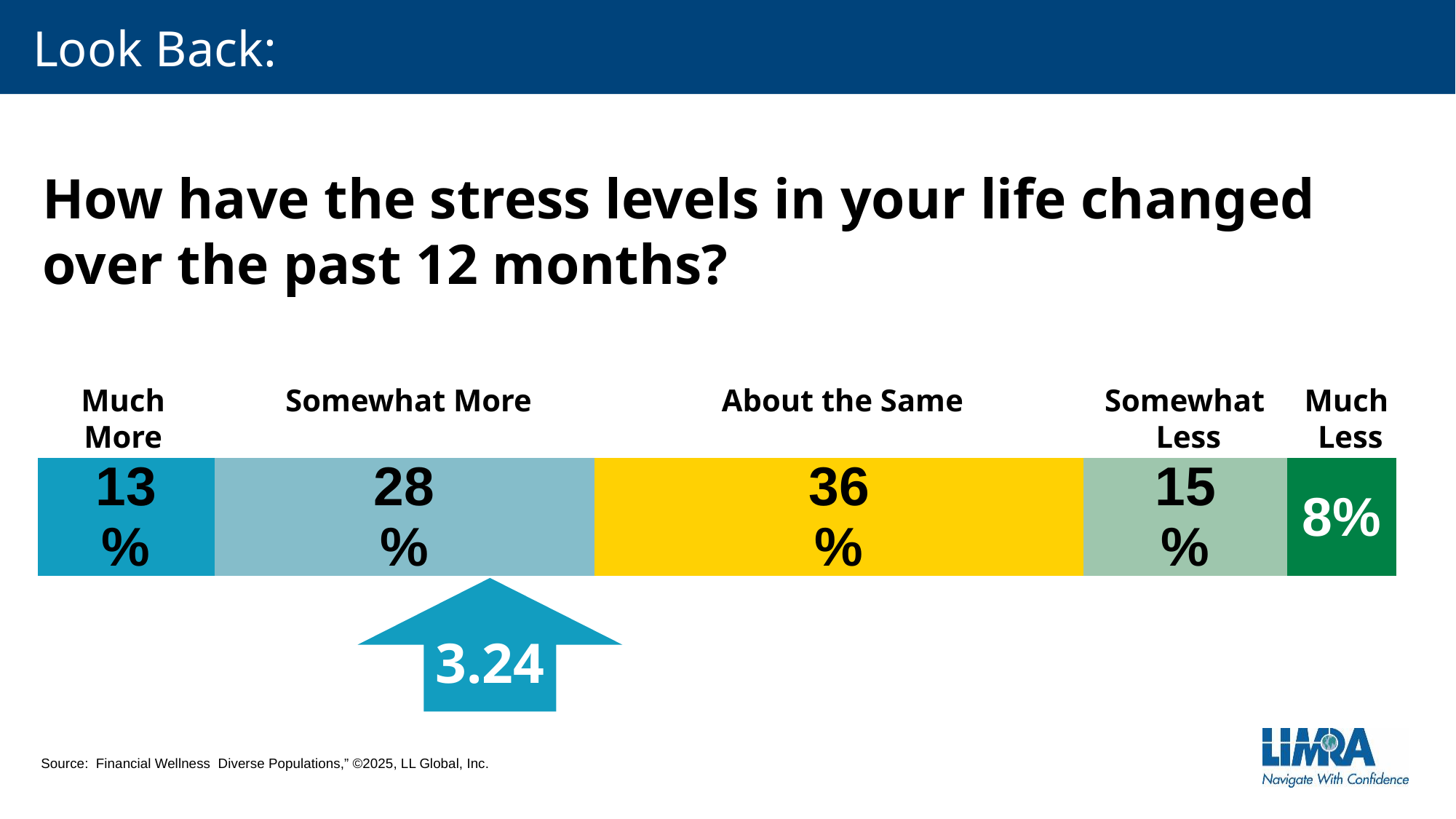
How many response categories are shown in the bar? 5 What is the combined percentage of respondents who said "Much More" or "Somewhat More"? 41% What percentage of respondents said their stress levels were "Somewhat Less"? 15% What percentage of respondents said their stress levels were "Much Less"? 8% Which response category has the highest percentage? About the Same What kind of chart is shown on the slide? Stacked bar chart Which is larger, the percentage for "Much More" or the percentage for "Somewhat Less"? Somewhat Less Which response category has the lowest percentage? Much Less What is the difference in percentage points between "Somewhat More" and "Somewhat Less"? 13 What percentage of respondents said their stress levels were "About the Same"? 36% What number is shown in the arrow below the "Somewhat More" segment? 3.24 What percentage of respondents said their stress levels were "Much More"? 13%